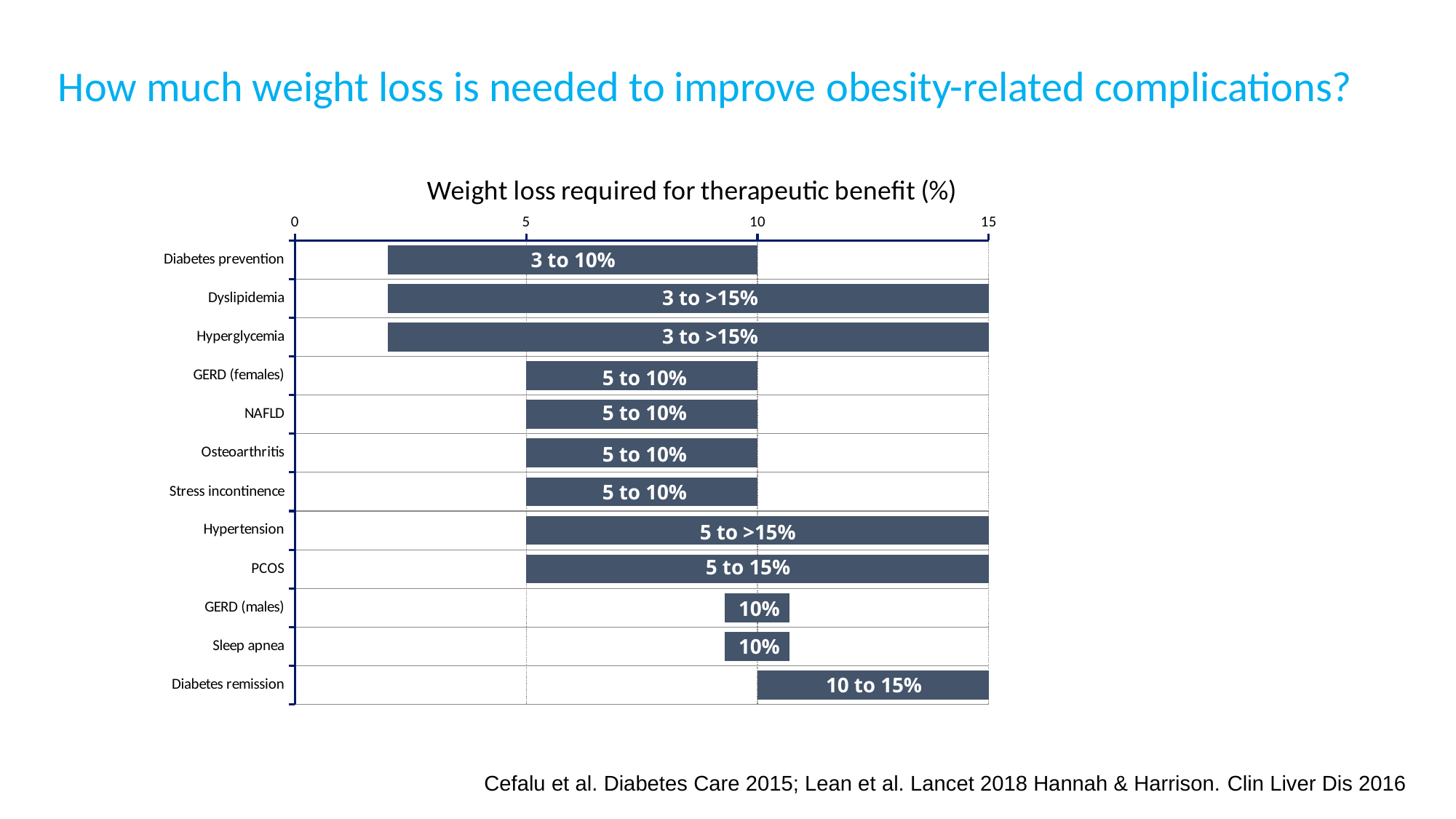
What weight loss range is shown for Diabetes prevention? 3 to 10% What weight loss range is shown for Hyperglycemia? 3 to >15% What weight loss range is shown for Diabetes remission? 10 to 15% Which bar covers a wider range on the axis, Diabetes prevention or GERD (females)? Diabetes prevention How many categories are labelled with the range '5 to 10%'? 4 How many complications (categories) are listed on the chart? 12 What value is labelled on the bar for Sleep apnea? 10% What is the title of the chart? Weight loss required for therapeutic benefit (%) What weight loss range is shown for PCOS? 5 to 15% What kind of chart is shown on the slide? Bar chart What weight loss range is shown for Hypertension? 5 to >15%